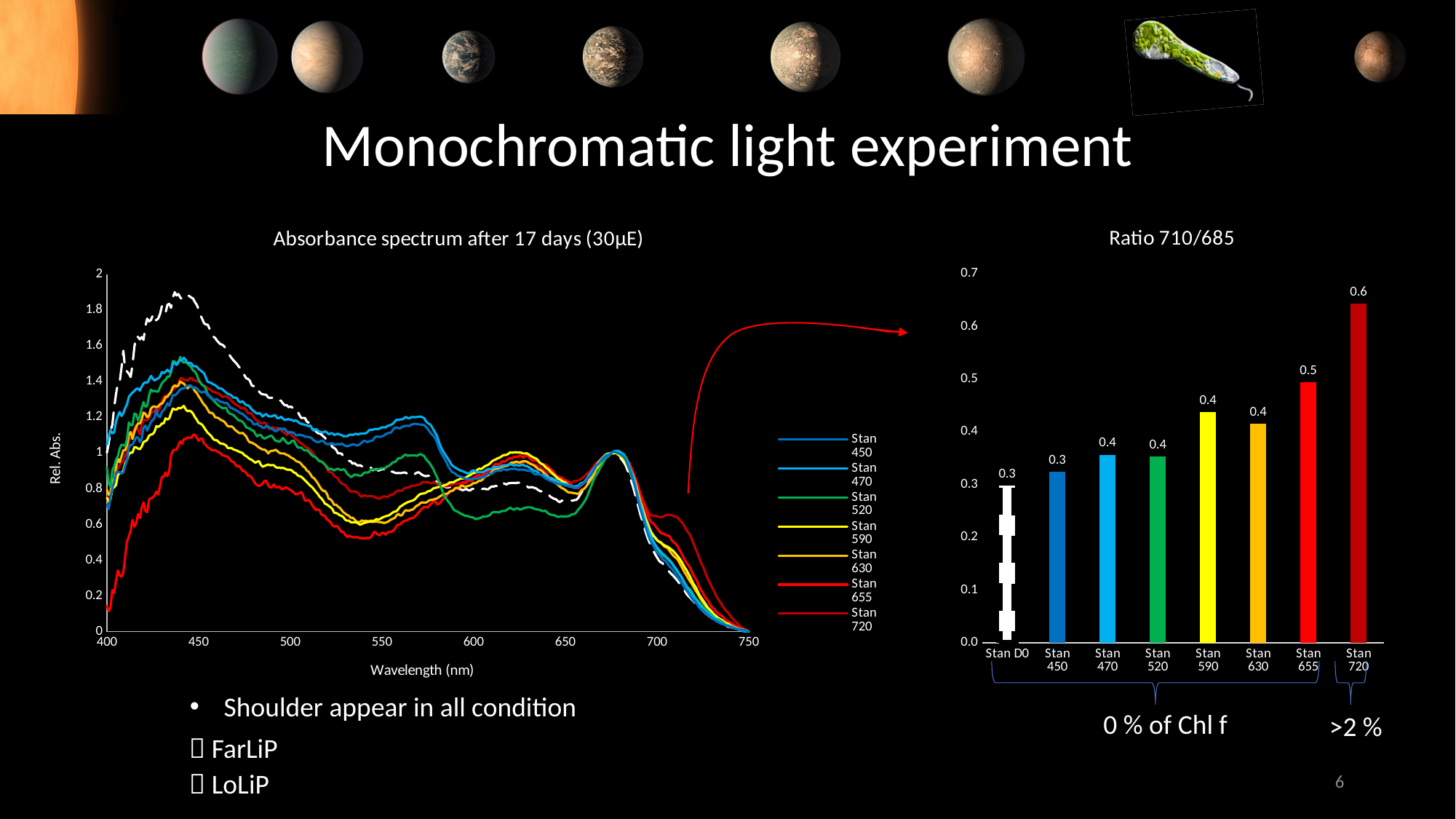
In the Ratio 710/685 chart, what is the difference between the value for Stan 720 and the value for Stan D0? 0.3 In the Ratio 710/685 chart, what is the value for Stan 655? 0.5 In the Ratio 710/685 chart, which is larger, the value for Stan 720 or the value for Stan 450? Stan 720 What kind of chart is the Ratio 710/685 chart? bar chart In the Ratio 710/685 chart, what is the value for Stan 720? 0.6 In the Ratio 710/685 chart, do the values generally rise or fall from left to right along the x axis? rise What is the x-axis label of the Absorbance spectrum after 17 days (30µE) chart? Wavelength (nm) How many series does the legend of the Absorbance spectrum after 17 days (30µE) chart list? 7 In the Ratio 710/685 chart, how many categories are shown on the x axis? 8 In the Ratio 710/685 chart, which category has the highest value? Stan 720 In the Ratio 710/685 chart, is the value for Stan 720 greater or less than 0.5? greater What kind of chart is the Absorbance spectrum after 17 days (30µE) chart? line chart